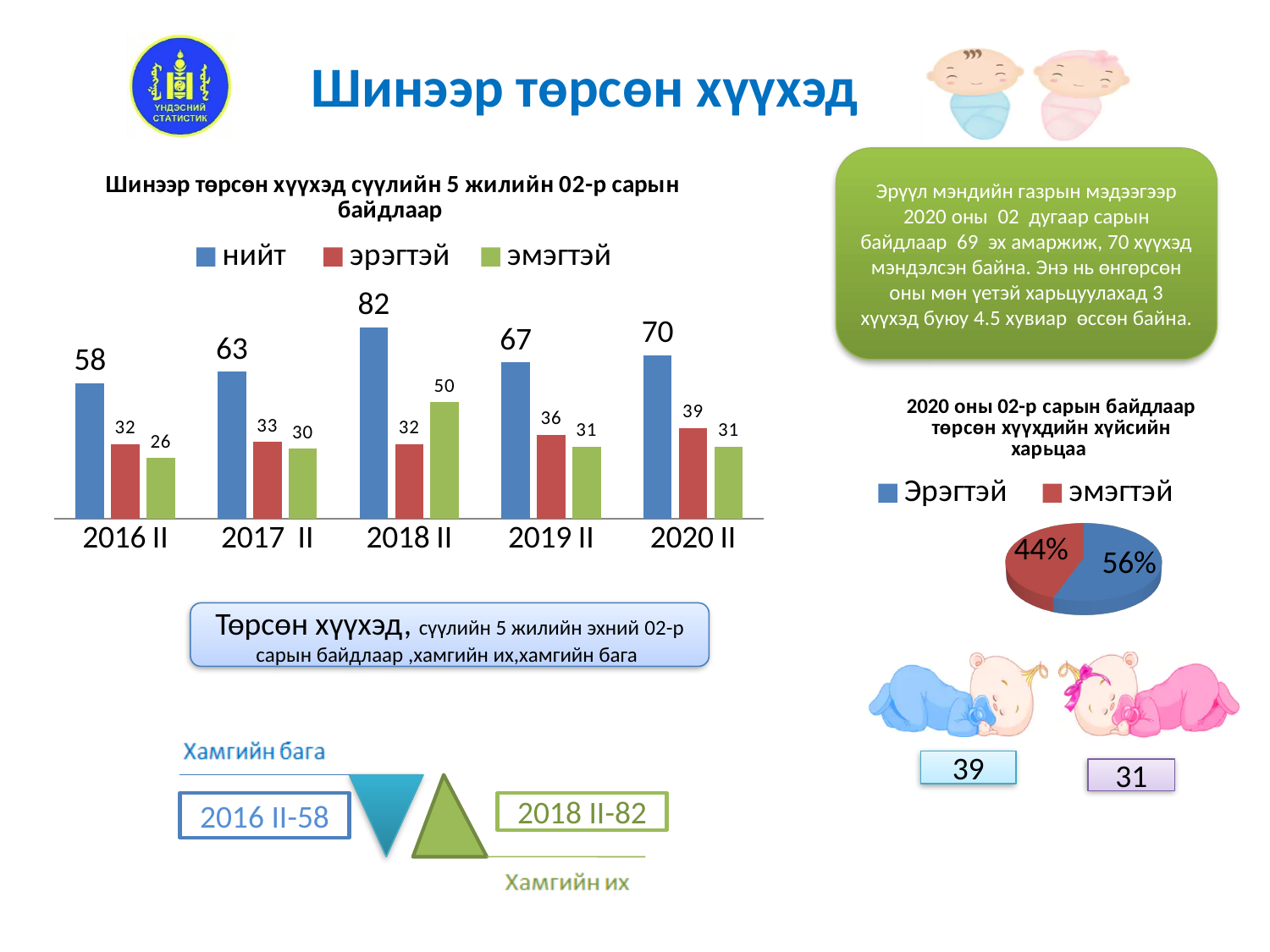
In the bar chart on the left, how many series does the legend list? 3 In the bar chart on the left, which year has the highest нийт value? 2018 II In the bar chart on the left, what is the value of эрэгтэй for 2020 II? 39 What kind of chart is the chart on the left of the slide? bar chart In the bar chart on the left, which is larger for 2018 II: эрэгтэй or эмэгтэй? эмэгтэй In the bar chart on the left, what is the value of нийт for 2018 II? 82 In the bar chart on the left, what is the difference between the нийт values for 2018 II and 2016 II? 24 In the bar chart on the left, what is the value of эмэгтэй for 2016 II? 26 In the bar chart on the left, which year has the lowest нийт value? 2016 II In the pie chart on the right, what share is Эрэгтэй? 56% In the pie chart on the right, which slice is larger: Эрэгтэй or эмэгтэй? Эрэгтэй In the bar chart on the left, how many years are shown on the x axis? 5